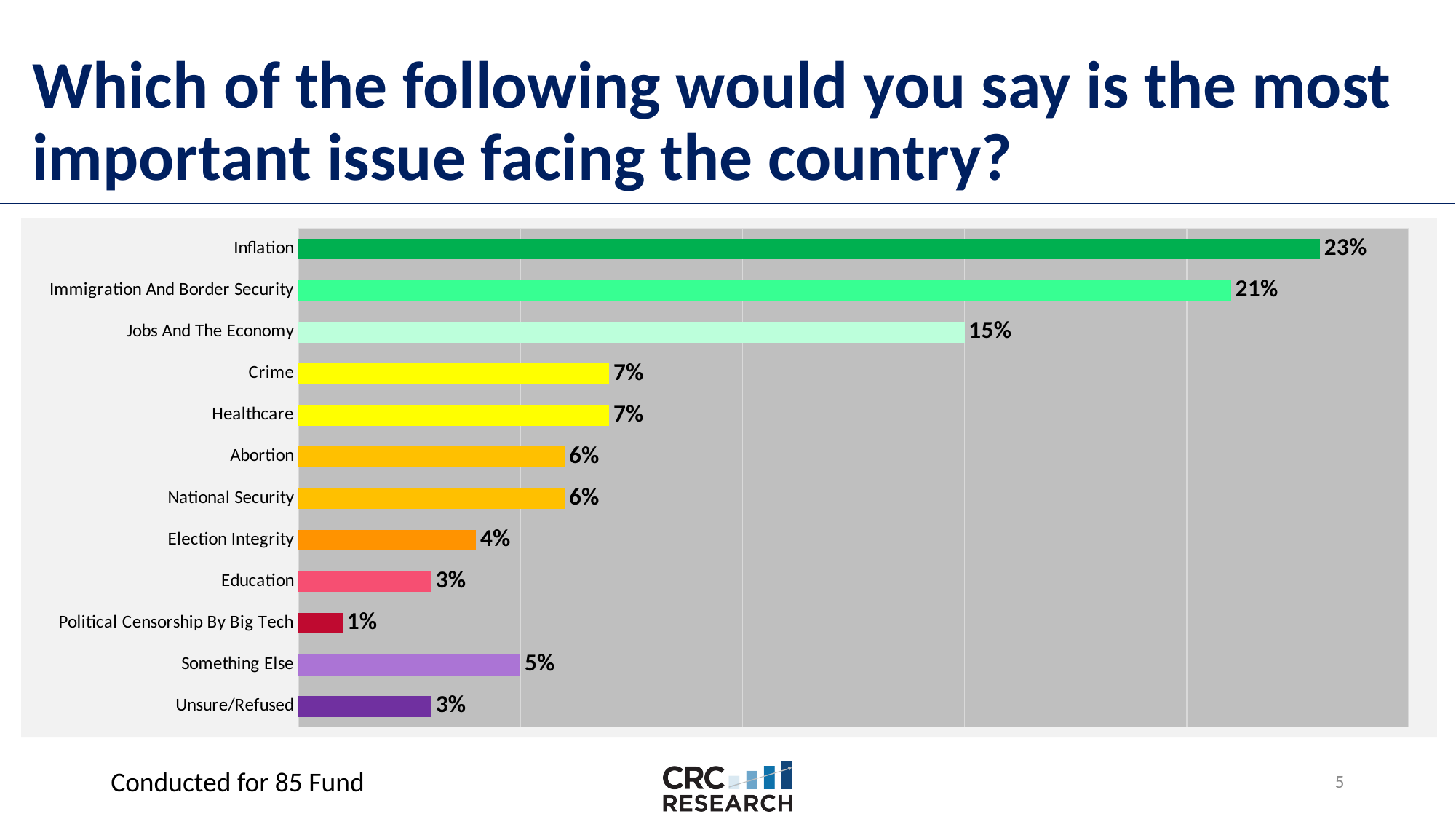
How many categories are shown on the chart? 12 Which is larger, the value for Election Integrity or the value for Something Else? Something Else What kind of chart is shown on the slide? Bar chart What is the difference between the values for Inflation and Immigration And Border Security? 2% What is the value for Political Censorship By Big Tech? 1% What percentage of respondents chose Inflation as the most important issue? 23% Which issue has the highest percentage on the chart? Inflation What percentage is shown for Jobs And The Economy? 15% What is the value shown for Immigration And Border Security? 21% What is the difference between the values for Jobs And The Economy and Crime? 8% Which issue has the lowest percentage on the chart? Political Censorship By Big Tech What colour is the bar for Inflation? Green